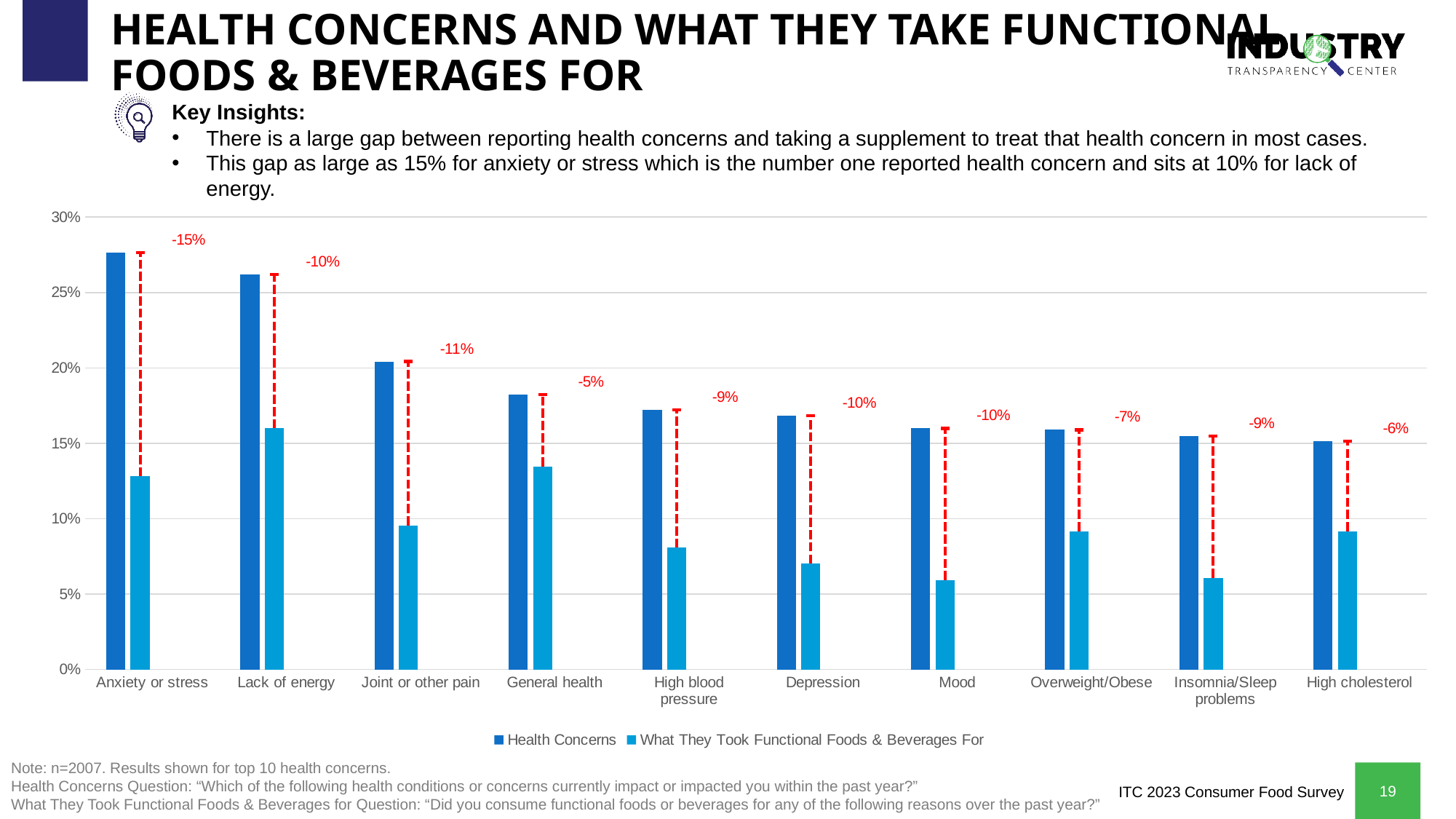
Which category has the smallest annotated gap between the two series? General health What gap is annotated in red above the Anxiety or stress bars? -15% Do the Health Concerns values rise or fall moving from left to right along the x axis? fall How many health concern categories are shown on the x axis? 10 What are the two series named in the legend? Health Concerns; What They Took Functional Foods & Beverages For Which has a larger Health Concerns value, Lack of energy or Joint or other pain? Lack of energy Is the What They Took Functional Foods & Beverages For value for Depression greater or less than 10%? less How many series does the legend list? 2 Is the Health Concerns value for Anxiety or stress greater or less than 25%? greater What kind of chart is shown on the slide? bar chart Which category has the highest Health Concerns value? Anxiety or stress What gap is annotated in red above the General health bars? -5%